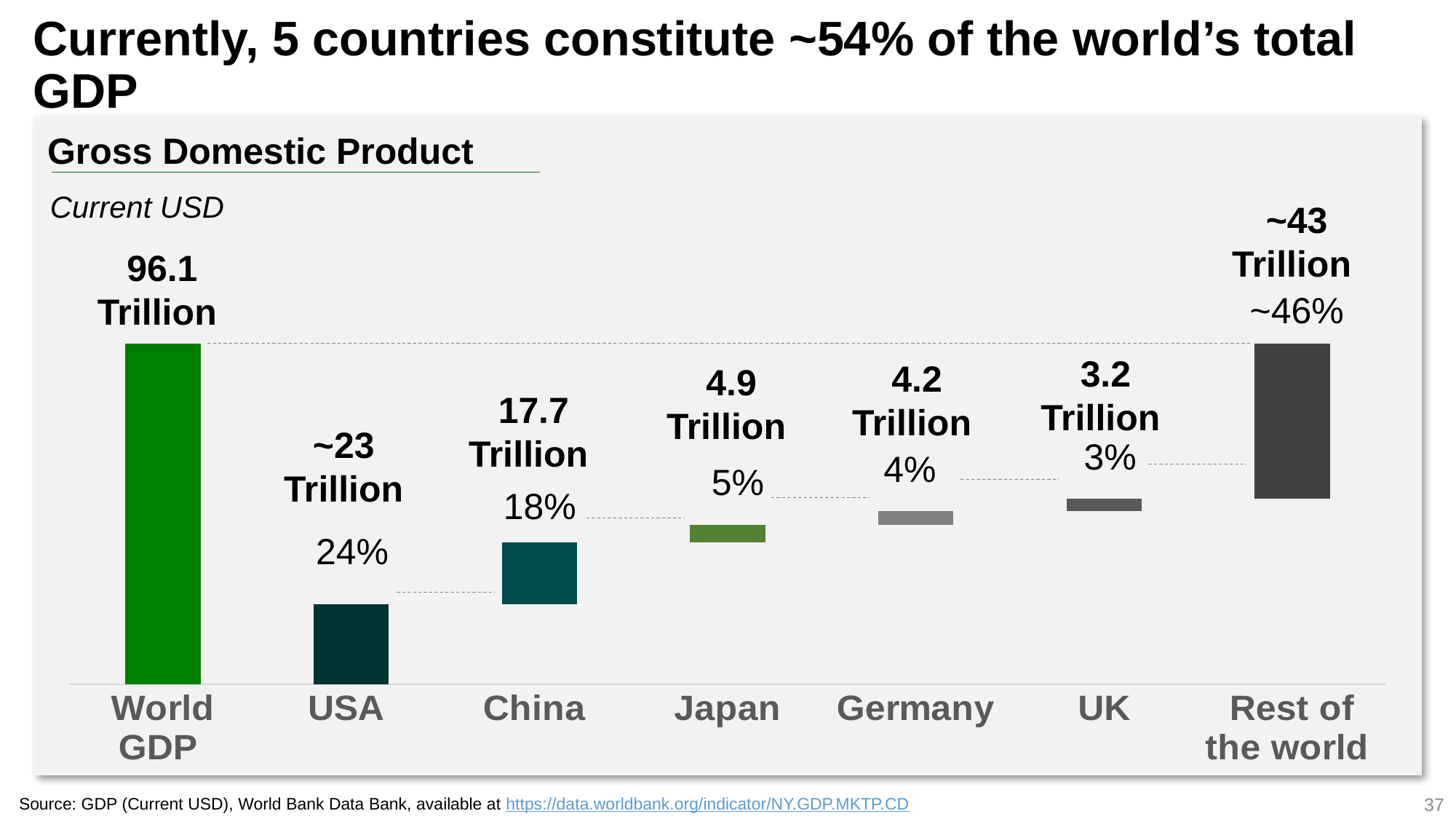
What is the difference between China's and Japan's GDP values? 12.8 Trillion What is the value shown for World GDP? 96.1 Trillion What percentage share is shown for Rest of the world? ~46% What is the difference between Germany's and the UK's GDP values? 1.0 Trillion Among the five named countries, which has the lowest GDP? UK What is the title of the chart? Gross Domestic Product Among the five named countries, which has the highest GDP? USA What percentage of world GDP is shown for the USA? 24% What is the GDP value shown for the UK? 3.2 Trillion What is the GDP value shown for China? 17.7 Trillion How many categories are shown along the x axis? 7 Which has a larger GDP, Japan or Germany? Japan